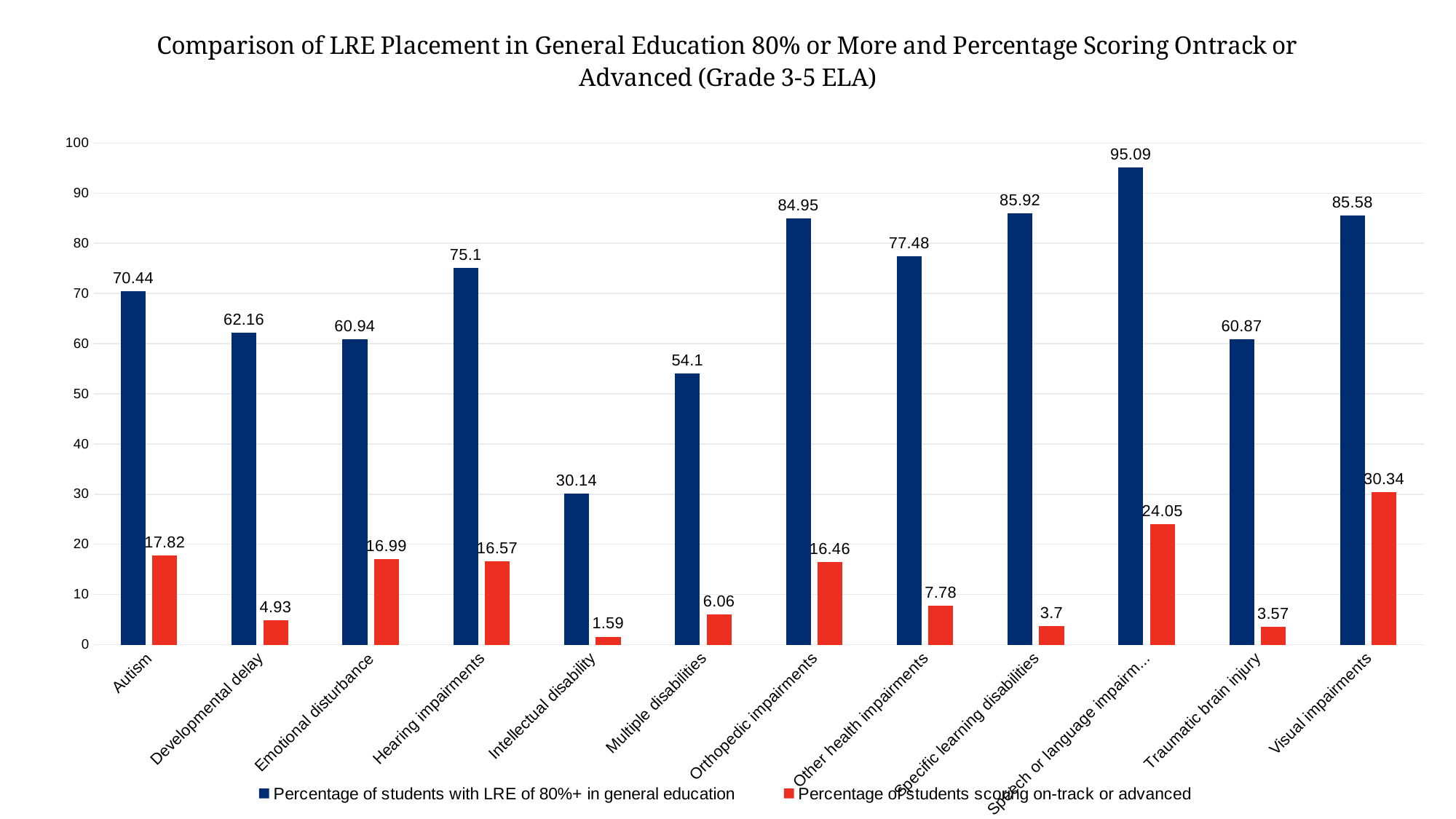
How many series does the legend list? 2 What is the percentage of students with LRE of 80%+ in general education for Multiple disabilities? 54.1 Which category has the lowest percentage of students with LRE of 80%+ in general education? Intellectual disability What kind of chart is shown on the slide? bar chart How many disability categories are shown on the x axis? 12 What is the percentage of students with LRE of 80%+ in general education for Autism? 70.44 What is the difference between the percentage of students with LRE of 80%+ in general education and the percentage scoring on-track or advanced for Autism? 52.62 What is the percentage of students scoring on-track or advanced for Visual impairments? 30.34 Is the percentage of students with LRE of 80%+ in general education for Multiple disabilities greater or less than 50? greater Which category has the lowest percentage of students scoring on-track or advanced? Intellectual disability Which has a higher percentage of students with LRE of 80%+ in general education: Hearing impairments or Other health impairments? Other health impairments Which category has the highest percentage of students scoring on-track or advanced? Visual impairments